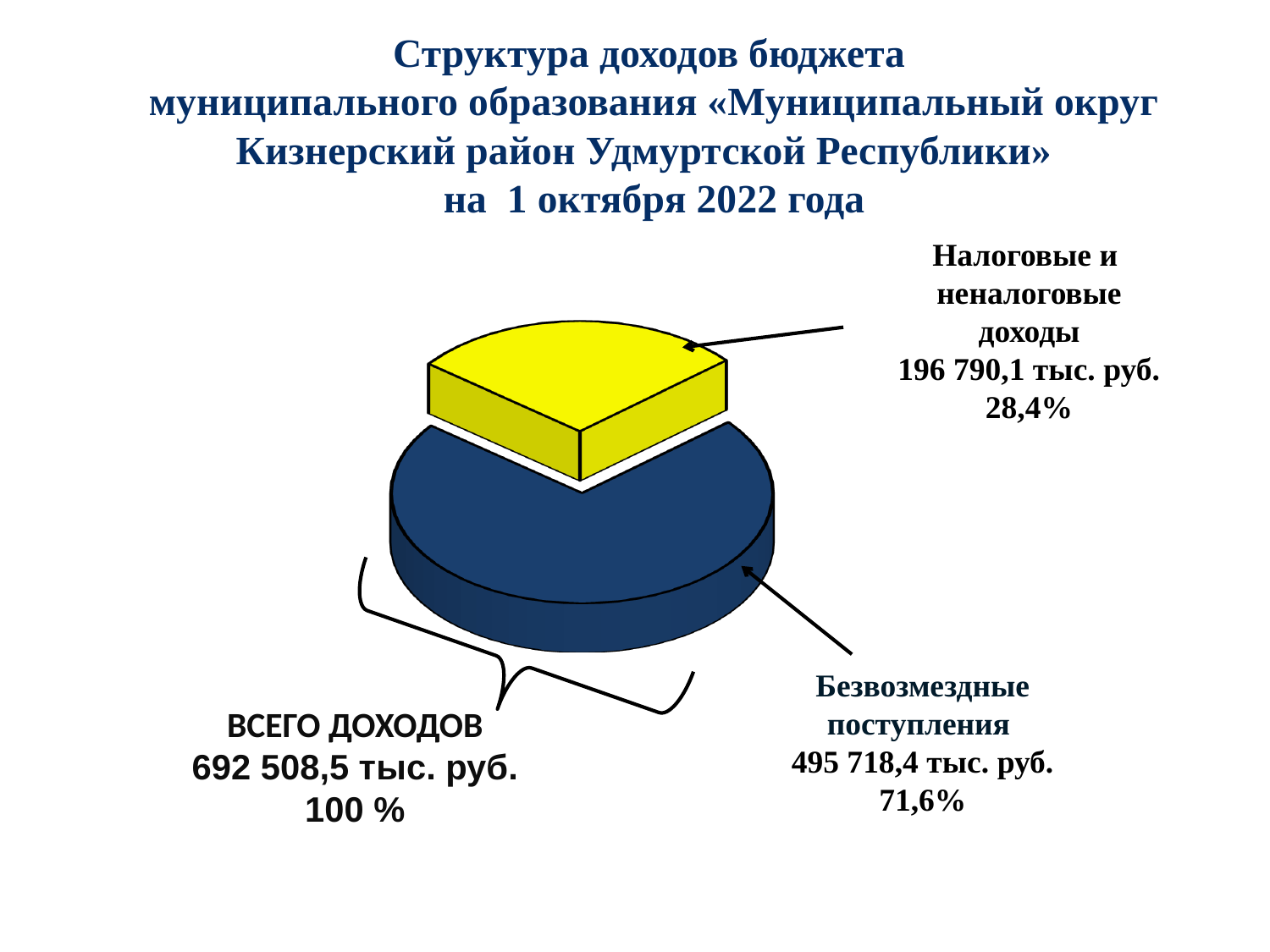
Which slice is the largest? Безвозмездные поступления What share of the pie does «Налоговые и неналоговые доходы» represent? 28,4% How many slices does the pie chart have? 2 What share of the pie does «Безвозмездные поступления» represent? 71,6% Which is larger: «Безвозмездные поступления» or «Налоговые и неналоговые доходы»? Безвозмездные поступления What colour is the slice for «Налоговые и неналоговые доходы»? Yellow What is the total of all revenues (ВСЕГО ДОХОДОВ) shown on the slide? 692 508,5 тыс. руб. What is the difference in тыс. руб. between «Безвозмездные поступления» and «Налоговые и неналоговые доходы»? 298 928,3 тыс. руб. What kind of chart is shown on the slide? Pie chart What is the value for «Налоговые и неналоговые доходы»? 196 790,1 тыс. руб. What is the value for «Безвозмездные поступления»? 495 718,4 тыс. руб. Which slice is the smallest? Налоговые и неналоговые доходы